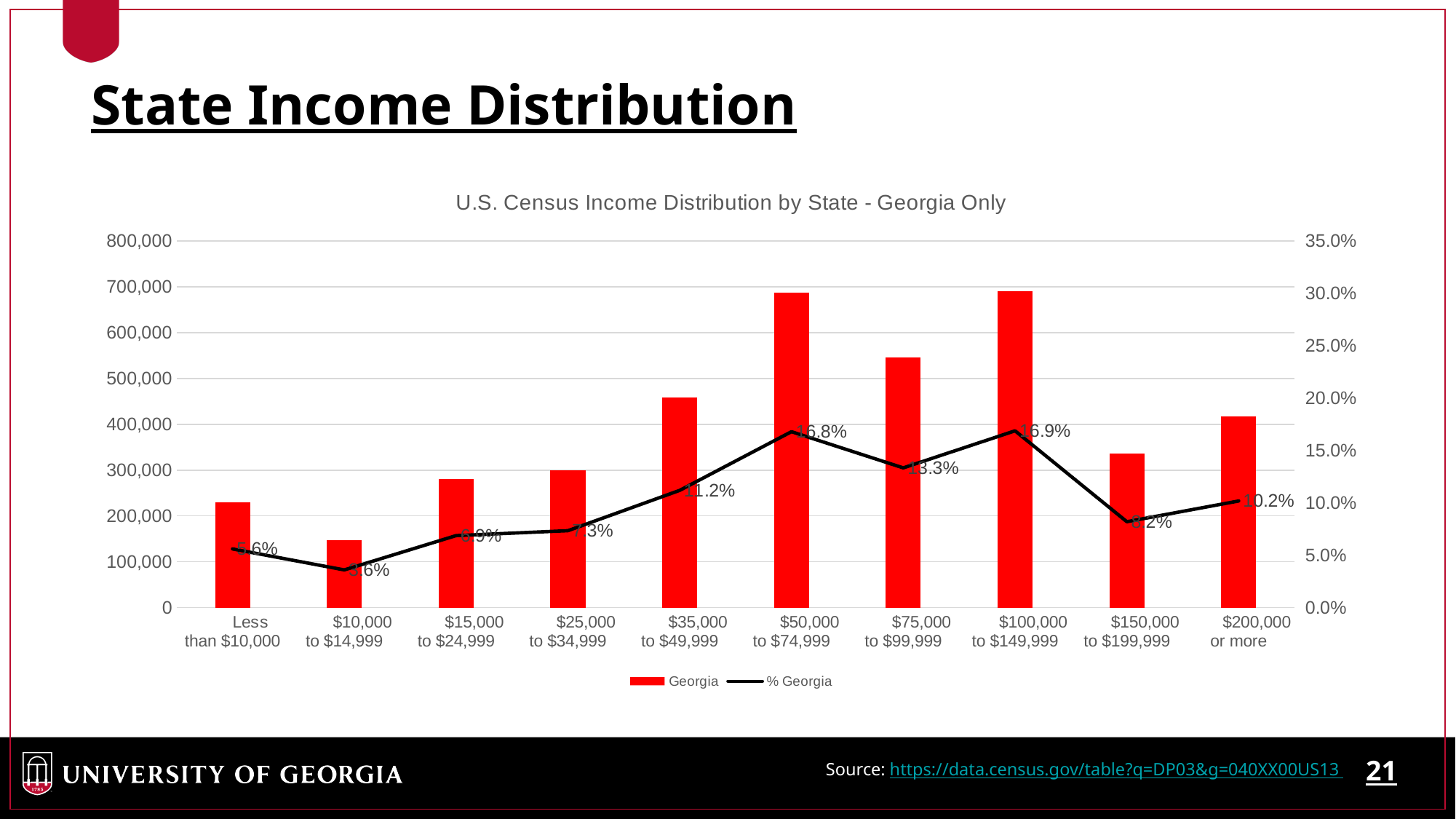
Which income bracket has the lowest Georgia bar? $10,000 to $14,999 Which has a larger % Georgia value: the $35,000 to $49,999 bracket or the $150,000 to $199,999 bracket? $35,000 to $49,999 Is the Georgia bar for the $35,000 to $49,999 bracket greater or less than 400,000? greater What is the difference between the % Georgia values for the $50,000 to $74,999 and $75,000 to $99,999 brackets? 3.5% What is the % Georgia value for the $10,000 to $14,999 income bracket? 3.6% What is the title of the chart? U.S. Census Income Distribution by State - Georgia Only What is the % Georgia value for the $200,000 or more income bracket? 10.2% How many series does the legend list? 2 Is the Georgia bar for the $150,000 to $199,999 bracket greater or less than 300,000? greater What is the % Georgia value for the $50,000 to $74,999 income bracket? 16.8% How many income brackets are shown on the x axis? 10 Which income bracket has the lowest % Georgia value on the line? $10,000 to $14,999